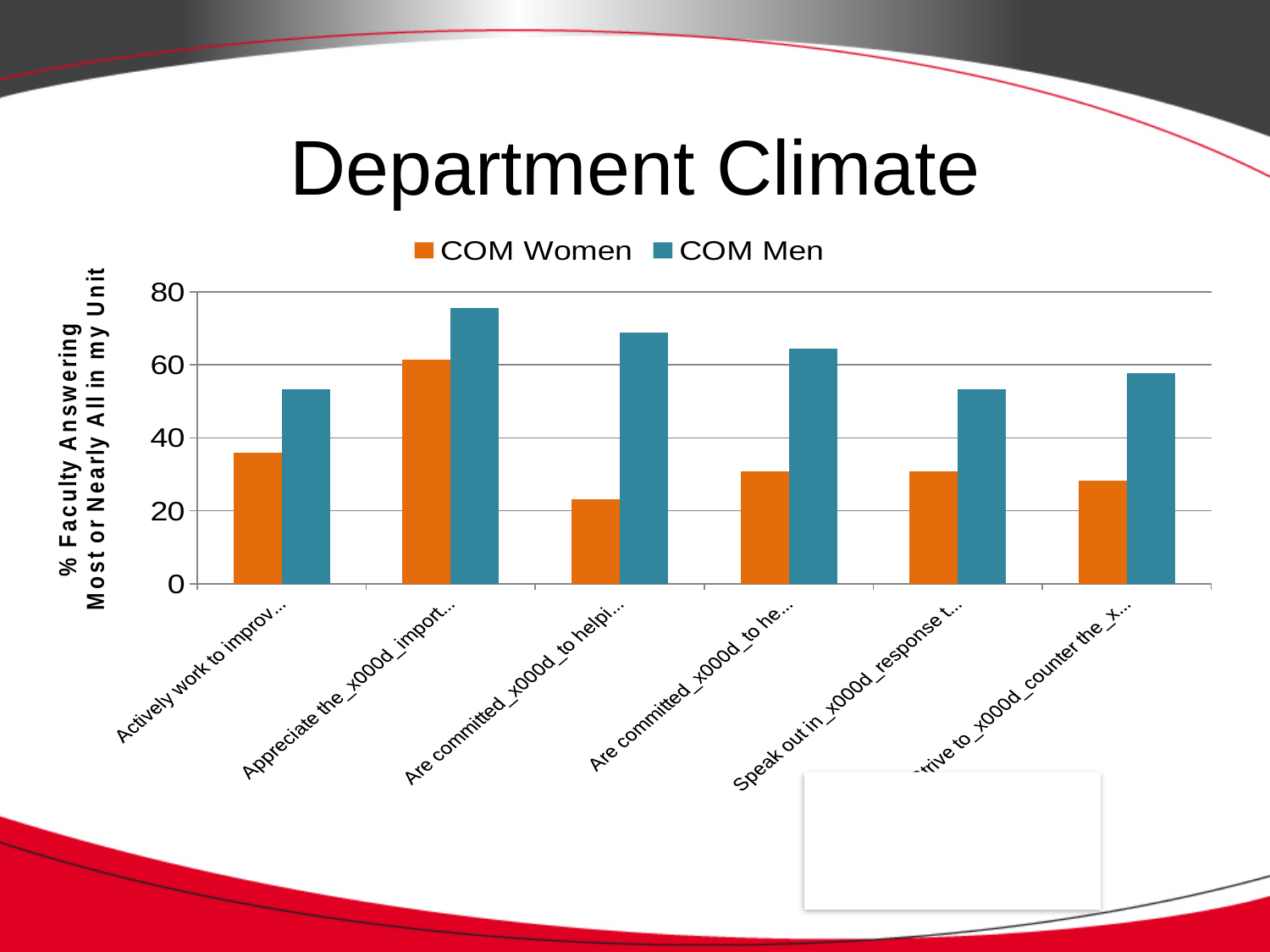
How many categories are plotted along the x axis? 6 Is the COM Women value for the first category ("Actively work to improv...") greater or less than 40? less For the first category ("Actively work to improv..."), which series has the larger value, COM Women or COM Men? COM Men How many series does the legend list? 2 Which category has the lowest COM Women value? Are committed... to helpi... (third category) Is the COM Men value for the second category ("Appreciate the... import...") greater or less than 60? greater What kind of chart is shown on the slide? bar chart Is the COM Women value for the third category ("Are committed... to helpi...") greater or less than 40? less Which category has the highest COM Men value? Appreciate the... import... (second category) What is the title of the y axis? % Faculty Answering Most or Nearly All in my Unit What colour are the COM Women bars? orange